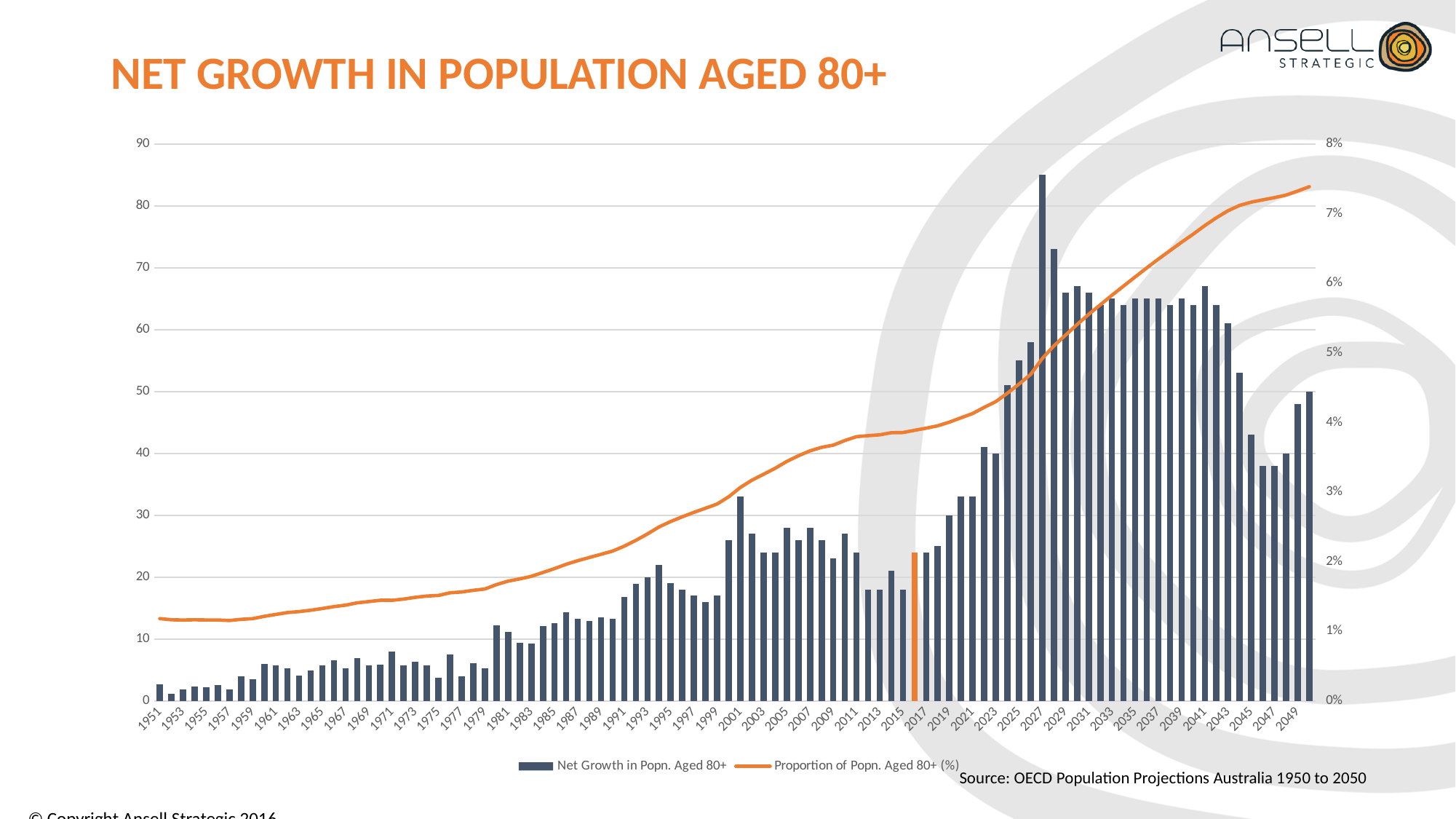
Is the Proportion of Popn. Aged 80+ (%) line value for 2049 greater or less than 7%? greater Is the Net Growth in Popn. Aged 80+ bar for 2001 greater or less than 30? greater Which year has the highest bar for Net Growth in Popn. Aged 80+? 2027 How many series does the legend list? 2 Is the Net Growth in Popn. Aged 80+ bar for 2027 greater or less than 80? greater Which year has the larger Net Growth in Popn. Aged 80+ bar, 2027 or 2029? 2027 What kind of chart is shown on the slide? A combined bar and line chart Does the Proportion of Popn. Aged 80+ (%) line generally rise or fall from 1951 to 2049? Rise What colour is the Proportion of Popn. Aged 80+ (%) line? Orange What is the title of the chart? NET GROWTH IN POPULATION AGED 80+